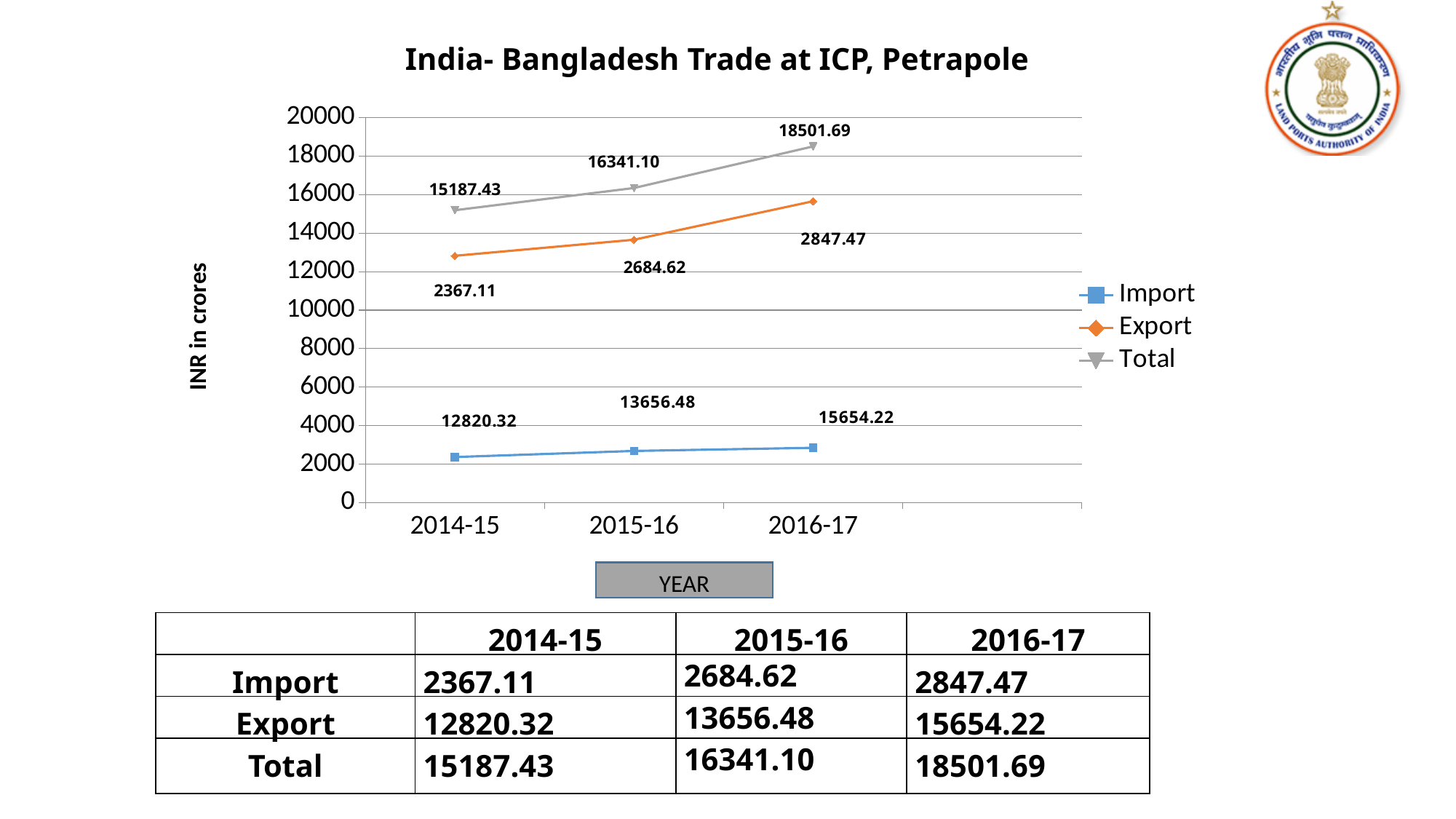
What is the Total trade value for 2016-17? 18501.69 How many series does the legend list? 3 What is the title of the chart? India- Bangladesh Trade at ICP, Petrapole Does the Total series rise or fall from 2014-15 to 2016-17? rise Which is larger in 2016-17, Import or Export? Export In which year is the Export value lowest? 2014-15 What is the Export value for 2015-16? 13656.48 What is the Import value for 2014-15? 2367.11 In which year is the Total trade value highest? 2016-17 What is the difference between the Total values for 2016-17 and 2015-16? 2160.59 How many years are plotted on the x axis? 3 What type of chart is shown on the slide? line chart